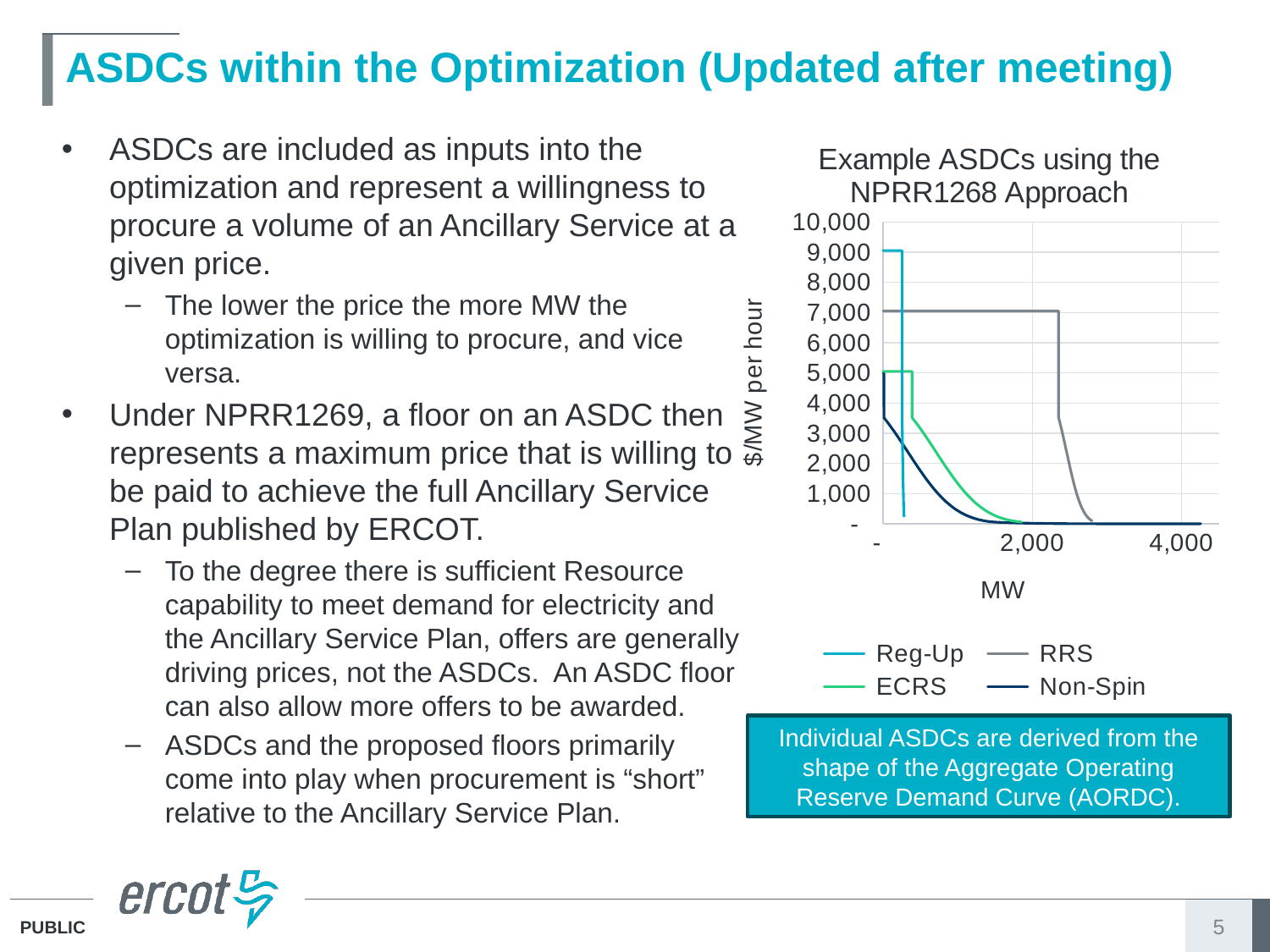
What is the label of the vertical axis of the chart? $/MW per hour Which series reaches zero at the smallest MW value? Reg-Up Which is higher: the flat portion of the RRS curve or the flat portion of the ECRS curve? RRS What kind of chart is shown on the slide? Line chart Is the flat portion of the RRS curve greater or less than 8,000? less What is the title of the chart? Example ASDCs using the NPRR1268 Approach Which series reaches the highest price ($/MW per hour) on the chart? Reg-Up Is the highest value of the Non-Spin curve greater or less than 6,000? less Which series extends furthest along the MW axis before reaching zero? RRS How many series does the legend of the chart list? 4 Is the highest value of the Reg-Up curve greater or less than 8,000? greater Do the curves rise or fall as MW increases along the x axis? Fall